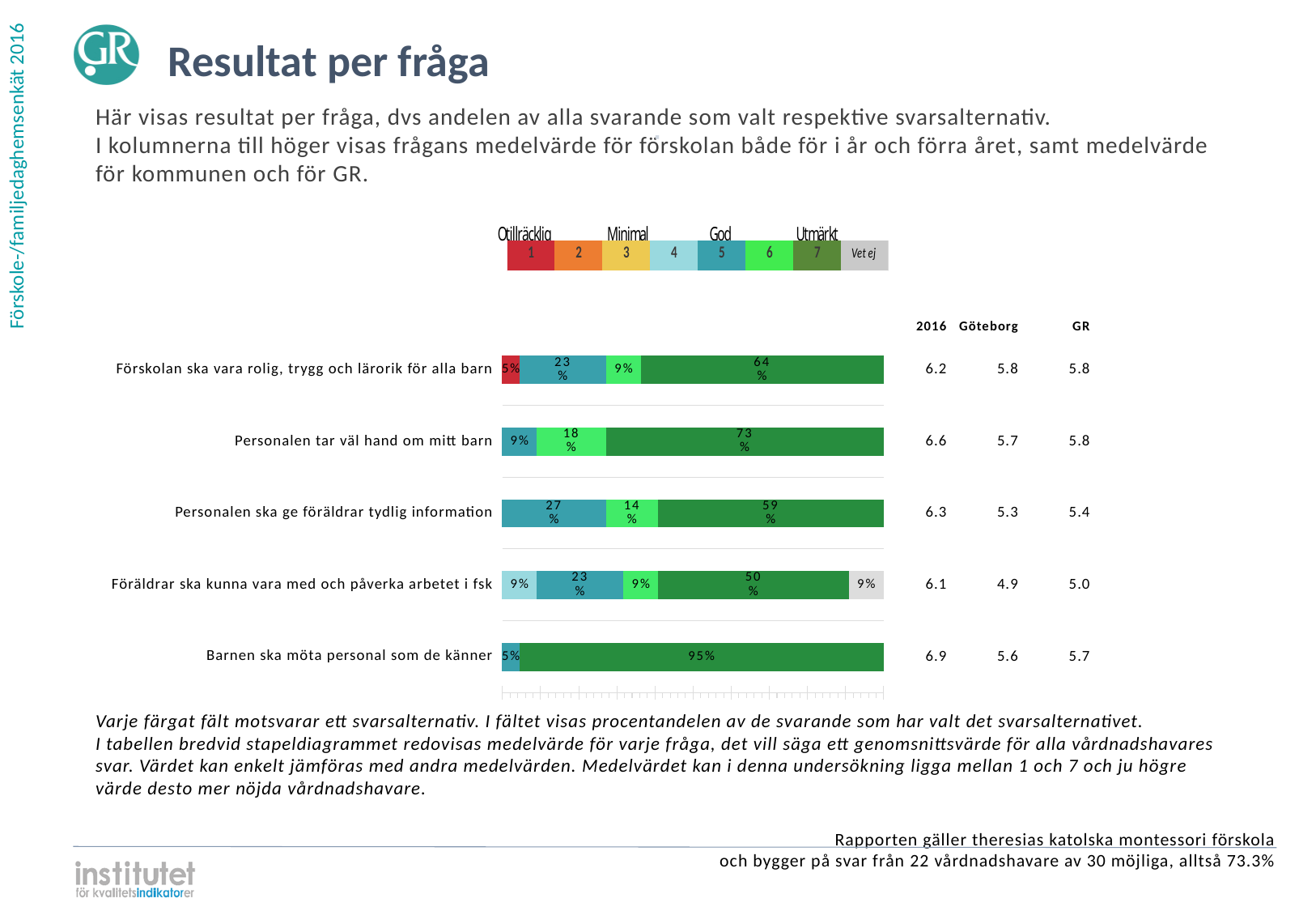
What is the Göteborg mean value for 'Föräldrar ska kunna vara med och påverka arbetet i fsk'? 4.9 Which question has the highest share of respondents choosing 7 (Utmärkt)? Barnen ska möta personal som de känner Which question has the lowest share of respondents choosing 7 (Utmärkt)? Föräldrar ska kunna vara med och påverka arbetet i fsk Which has a larger share of 7 (Utmärkt) answers: 'Personalen ska ge föräldrar tydlig information' or 'Förskolan ska vara rolig, trygg och lärorik för alla barn'? Förskolan ska vara rolig, trygg och lärorik för alla barn What percentage of respondents chose 7 (Utmärkt) for 'Barnen ska möta personal som de känner'? 95% What kind of chart is shown on the slide? Stacked bar chart Which question's bar includes a 'Vet ej' segment? Föräldrar ska kunna vara med och påverka arbetet i fsk What is the 2016 mean value for 'Barnen ska möta personal som de känner'? 6.9 How many questions (bars) are shown in the chart? 5 What is the total of the segments in the bar for 'Föräldrar ska kunna vara med och påverka arbetet i fsk'? 100% What percentage of respondents chose 7 (Utmärkt) for 'Personalen tar väl hand om mitt barn'? 73% How many percentage points higher is the 7 (Utmärkt) share for 'Personalen tar väl hand om mitt barn' than for 'Förskolan ska vara rolig, trygg och lärorik för alla barn'? 9 percentage points